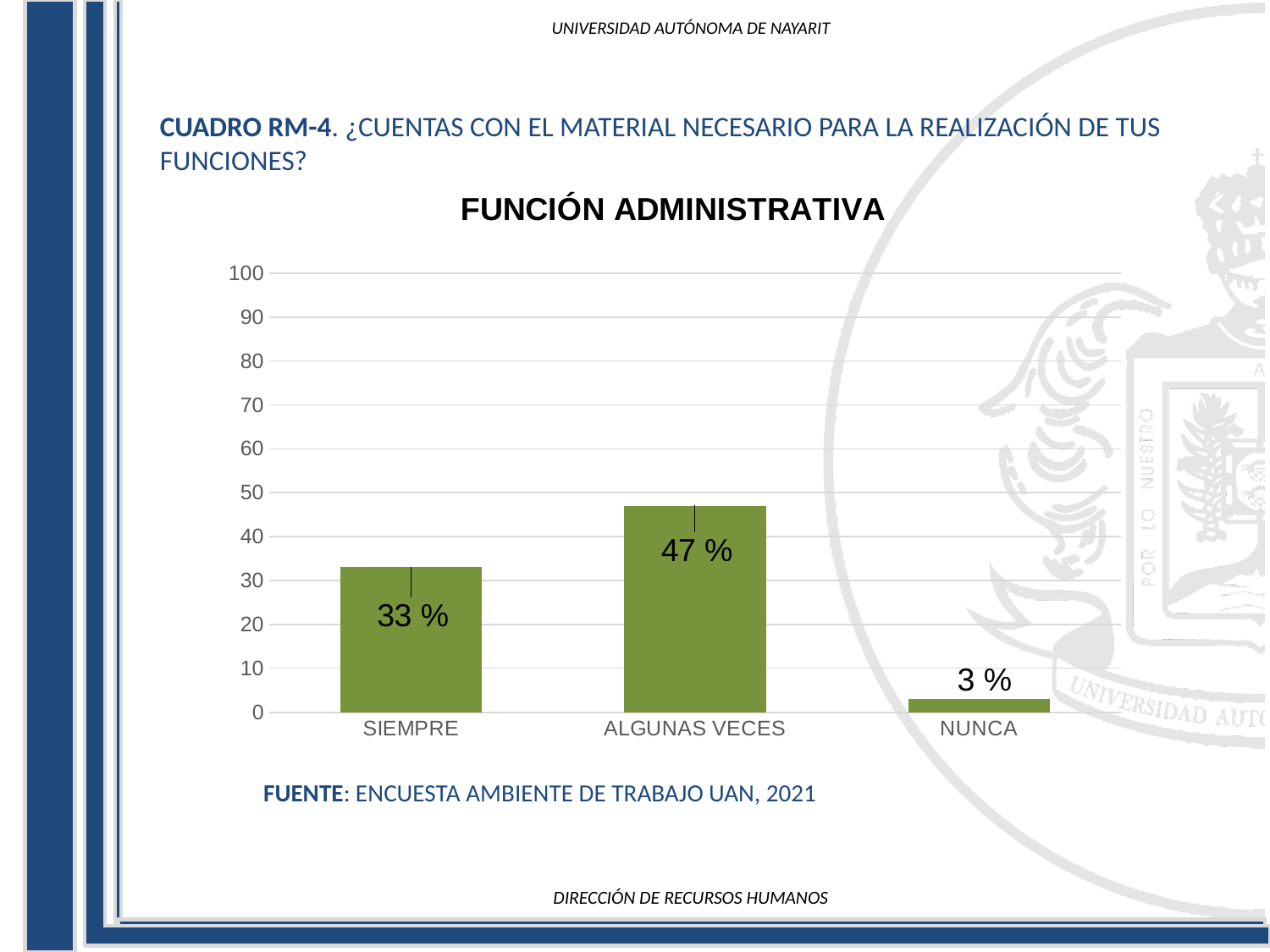
What is the highest value shown on the y axis? 100 Which category has the lowest value? NUNCA What is the value for SIEMPRE? 33 % What is the title of the chart? FUNCIÓN ADMINISTRATIVA What kind of chart is shown on the slide? bar chart What is the value for ALGUNAS VECES? 47 % Is the value for ALGUNAS VECES greater or less than 40? greater What is the value for NUNCA? 3 % How many categories are shown on the x axis? 3 Which category has the highest value? ALGUNAS VECES What is the difference between the values for ALGUNAS VECES and SIEMPRE? 14 % Which is larger, the value for SIEMPRE or the value for NUNCA? SIEMPRE